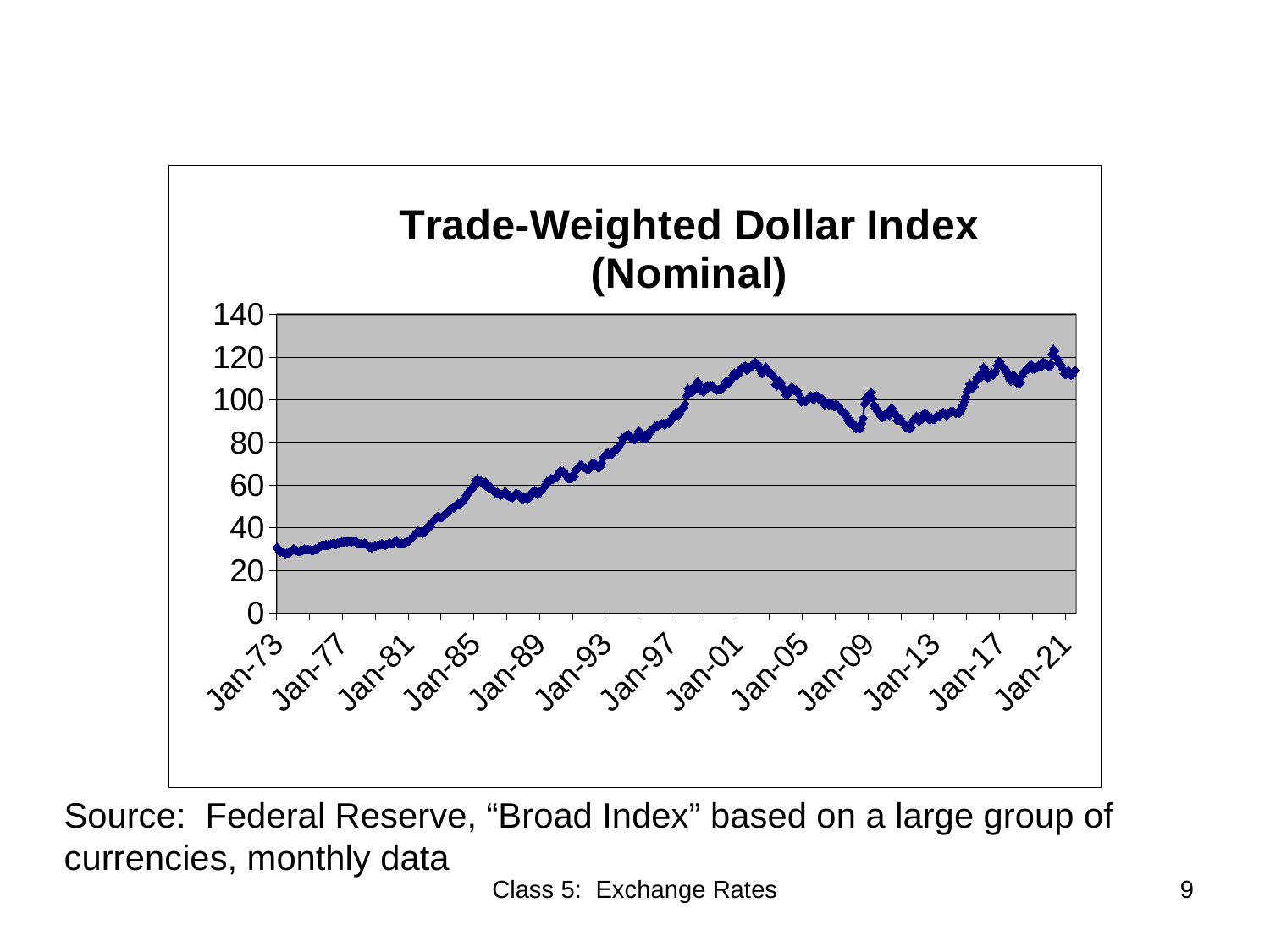
Which is larger, the value at Jan-85 or the value at Jan-01? Jan-01 Is the value at Jan-01 greater or less than 100? greater Is the value at Jan-21 greater or less than 100? greater What is the highest value shown on the vertical axis? 140 Is the value at Jan-73 greater or less than 40? less Which is larger, the value at Jan-73 or the value at Jan-21? Jan-21 What kind of chart is shown on the slide? line chart What is the title of the chart? Trade-Weighted Dollar Index (Nominal) Overall, does the index rise or fall from Jan-73 to Jan-21? rise How many date labels are shown along the x axis? 13